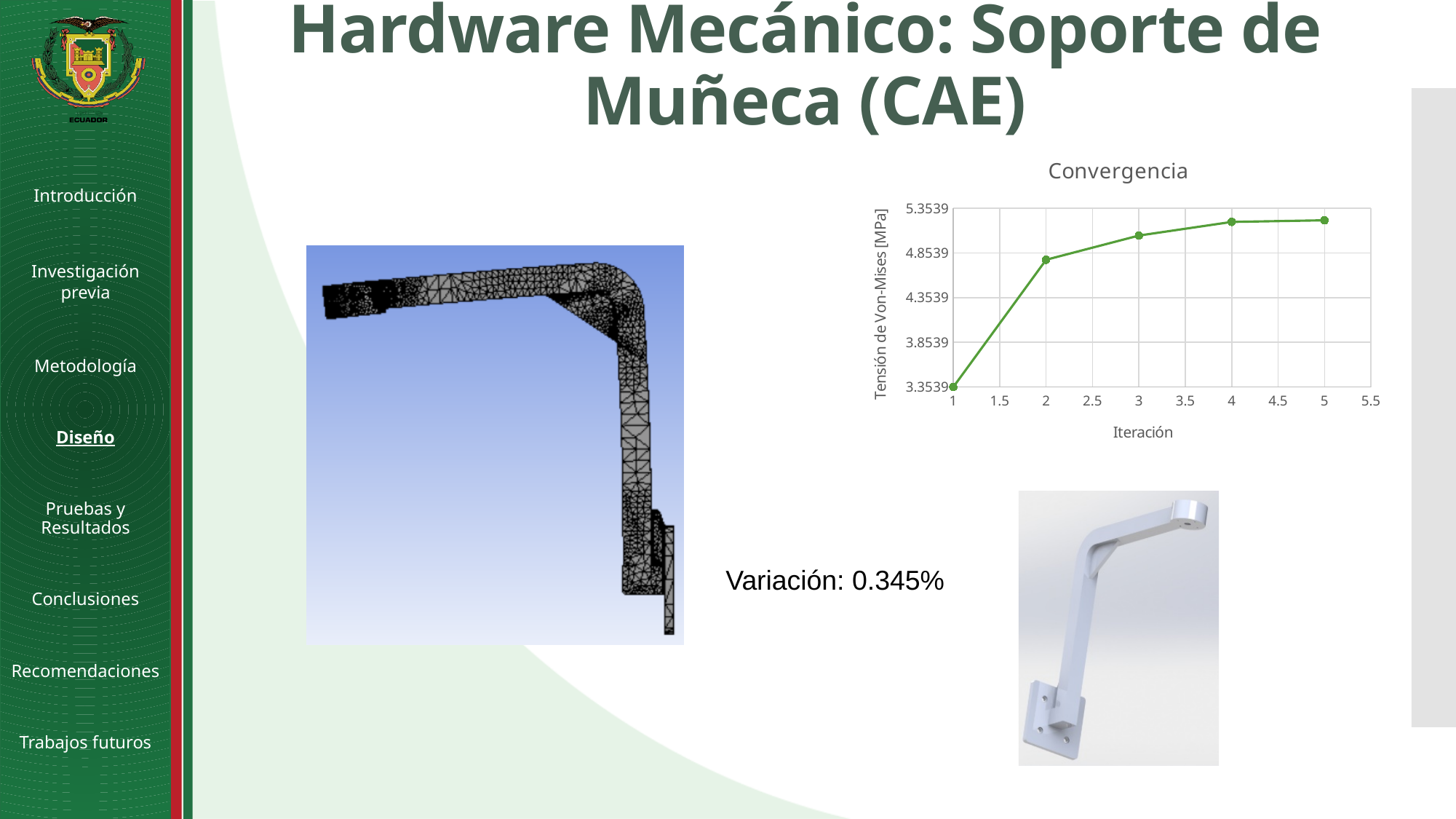
On the Convergencia chart, is the value for iteration 5 greater or less than 4.8539? greater On the Convergencia chart, is the value for iteration 2 greater or less than 4.8539? less How many data points are plotted on the Convergencia chart? 5 Do the values on the Convergencia chart rise or fall as the iteration number increases? rise What is the Von-Mises stress value at iteration 1 on the Convergencia chart? 3.3539 On the Convergencia chart, is the value for iteration 3 greater or less than 4.8539? greater On the Convergencia chart, which has the larger Von-Mises stress: iteration 2 or iteration 3? iteration 3 What is the title of the chart on the slide? Convergencia What kind of chart is the Convergencia chart? line chart What is the label of the y axis on the Convergencia chart? Tensión de Von-Mises [MPa] Which iteration has the lowest Von-Mises stress on the Convergencia chart? 1